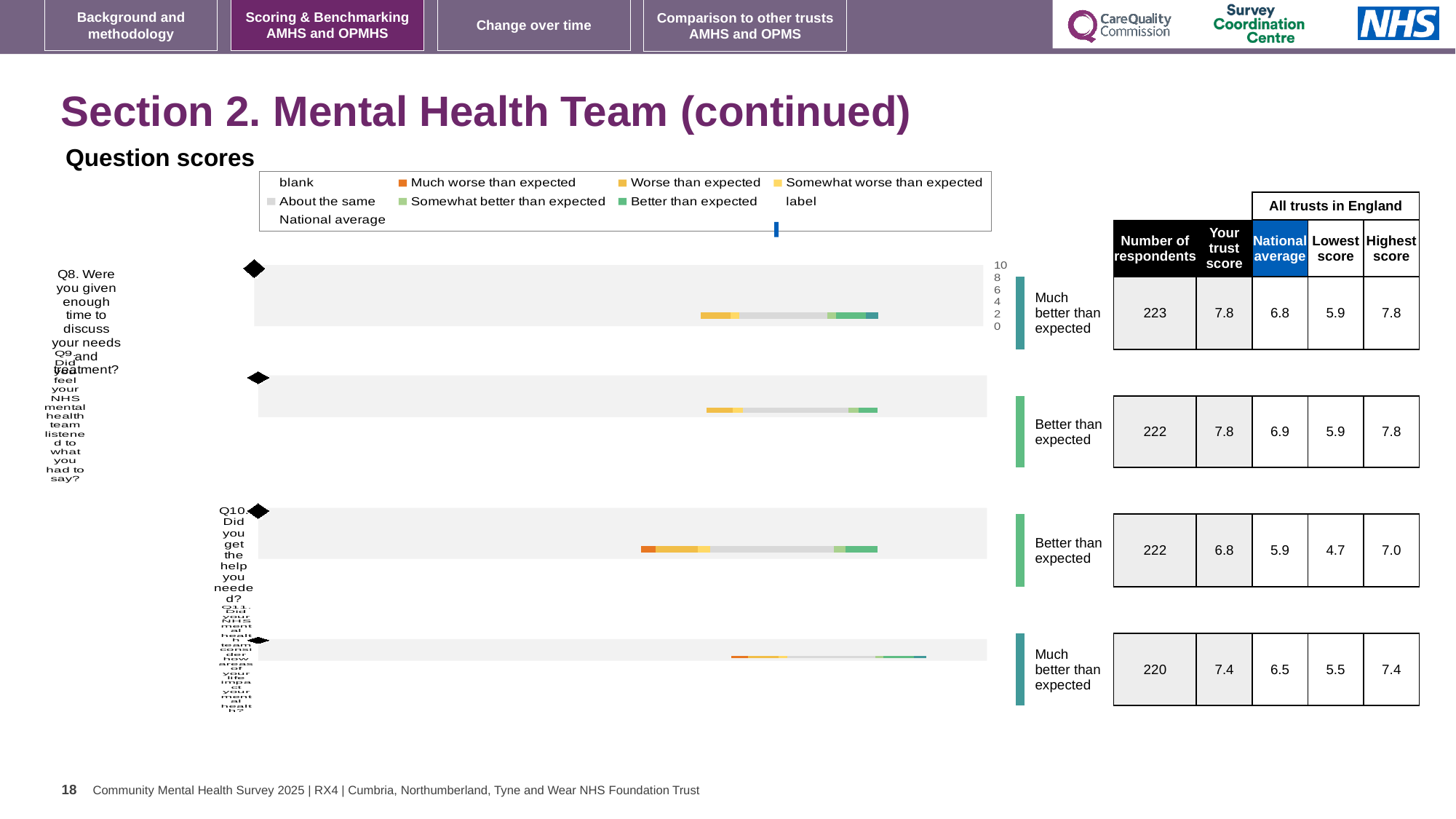
For the Q11 chart, what is the difference between the highest score and the lowest score? 1.9 For the Q10 chart, which is larger: the trust score or the national average? trust score In the legend, which colour represents 'Much worse than expected'? orange What kind of chart is used to show the question scores for Q8 to Q11? bar chart How many question charts (Q8 to Q11) are shown on the slide? 4 Which question (Q8 to Q11) has the lowest trust score? Q10 In the legend, which category is shown in grey? About the same For the Q9 chart, what rating label is shown next to it? Better than expected For the Q8 chart, what is the trust score shown? 7.8 For the Q10 chart, what is the national average shown? 5.9 For the Q11 chart, how many respondents are shown? 220 For the Q8 chart, how many respondents are shown in the table? 223